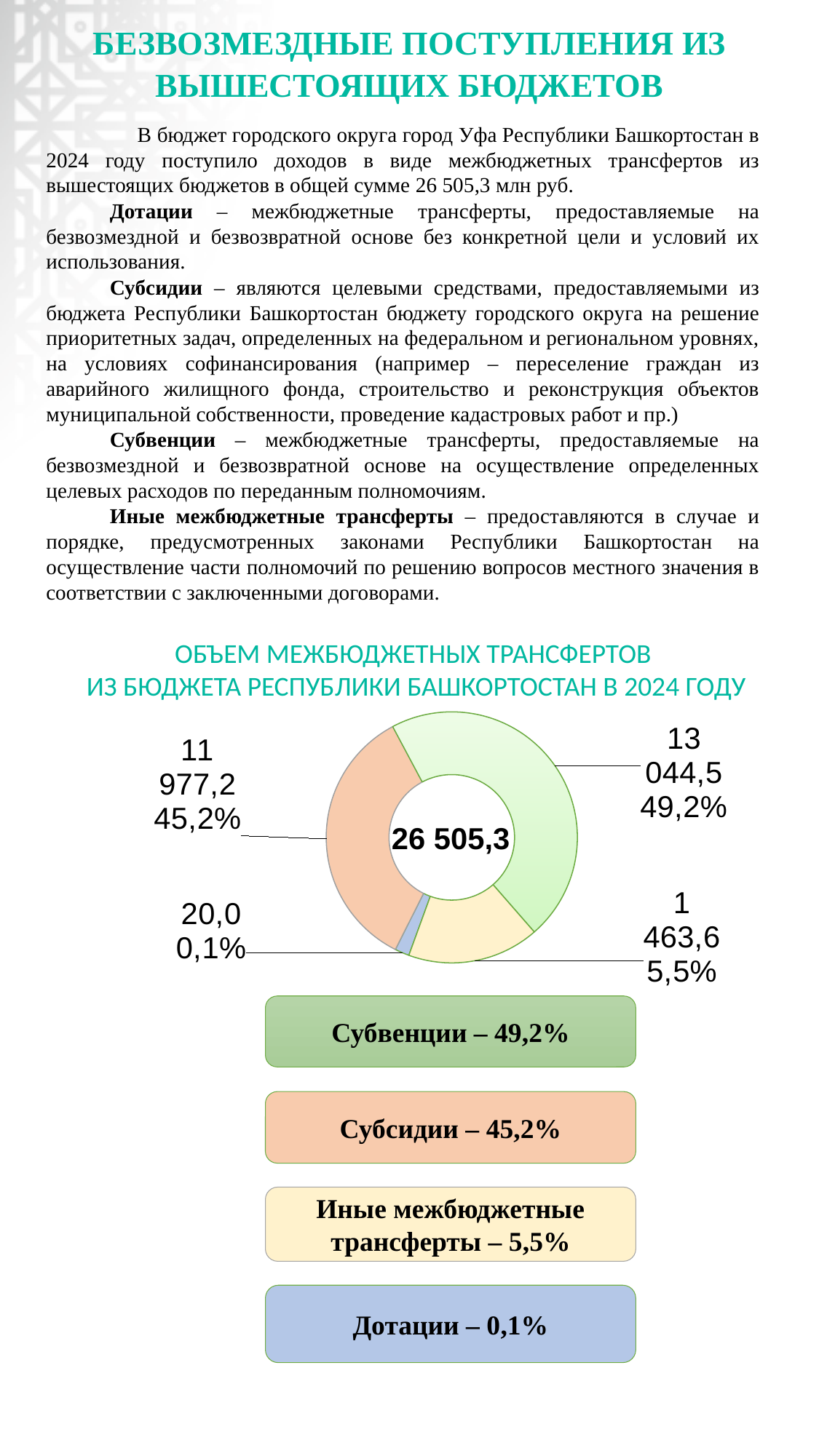
Which category has the smallest slice in the doughnut chart? Дотации What is the value shown for Субвенции in the doughnut chart? 13 044,5 What total value is shown in the centre of the doughnut chart? 26 505,3 What kind of chart is shown on the slide? Doughnut (pie) chart What share of the doughnut chart does Субвенции account for? 49,2% What is the value shown for Субсидии in the doughnut chart? 11 977,2 How many categories are shown in the doughnut chart? 4 What share of the doughnut chart does Дотации account for? 0,1% What is the value shown for Дотации in the doughnut chart? 20,0 What is the difference between the values for Субвенции and Субсидии? 1 067,3 Which category has the largest slice in the doughnut chart? Субвенции What is the value shown for Иные межбюджетные трансферты in the doughnut chart? 1 463,6